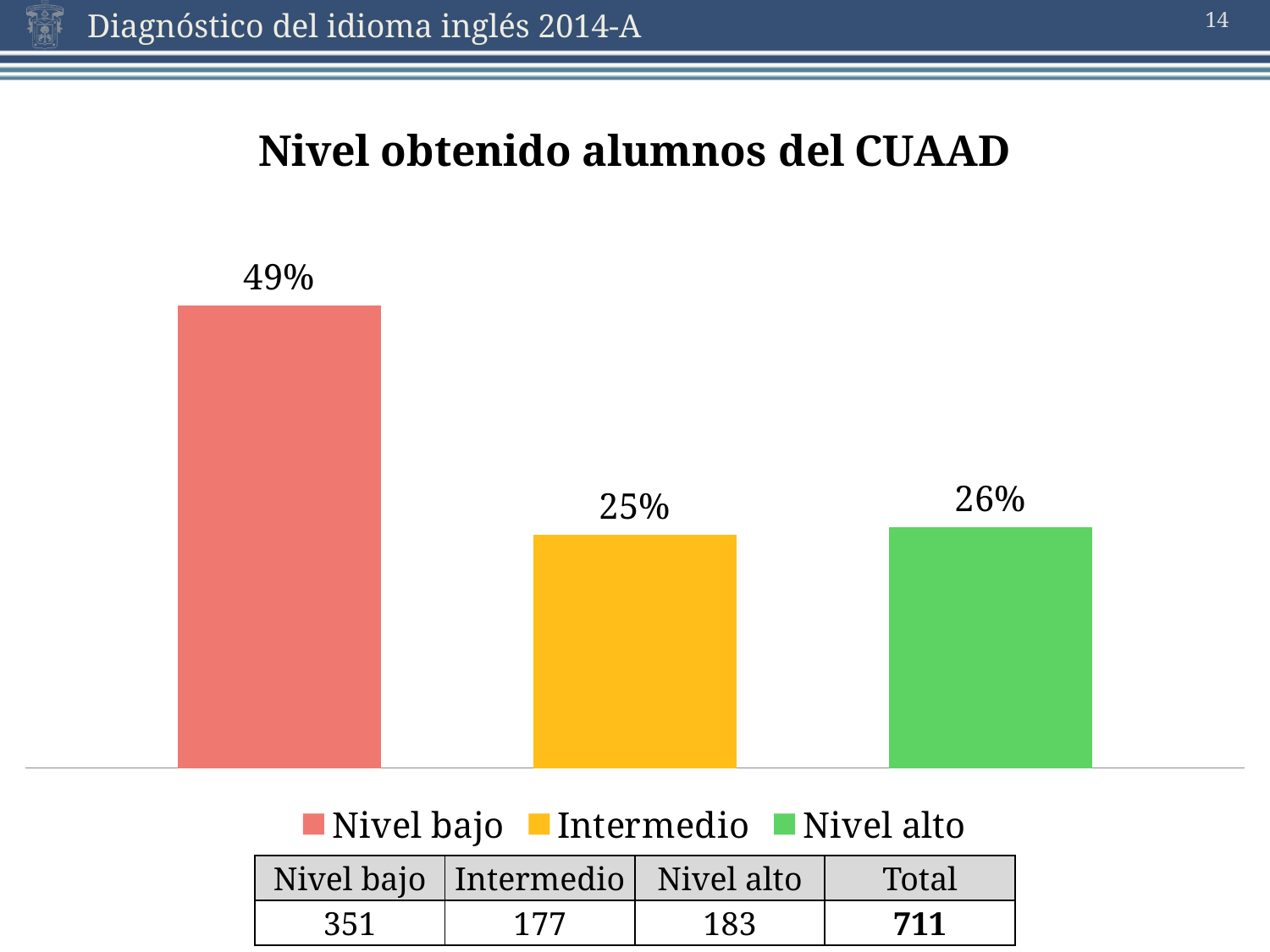
What is the difference in percentage points between Nivel bajo and Intermedio? 24 How many entries does the legend list? 3 Which level has the highest percentage? Nivel bajo How many bars are plotted in the chart? 3 What type of chart is shown? Bar chart What percentage is shown for Nivel alto? 26% What percentage is shown for Intermedio? 25% What is the difference in percentage points between Nivel bajo and Nivel alto? 23 What is the title of the chart? Nivel obtenido alumnos del CUAAD What percentage is shown for Nivel bajo? 49% Which level has the lowest percentage? Intermedio Which is larger, the percentage for Nivel bajo or for Intermedio? Nivel bajo